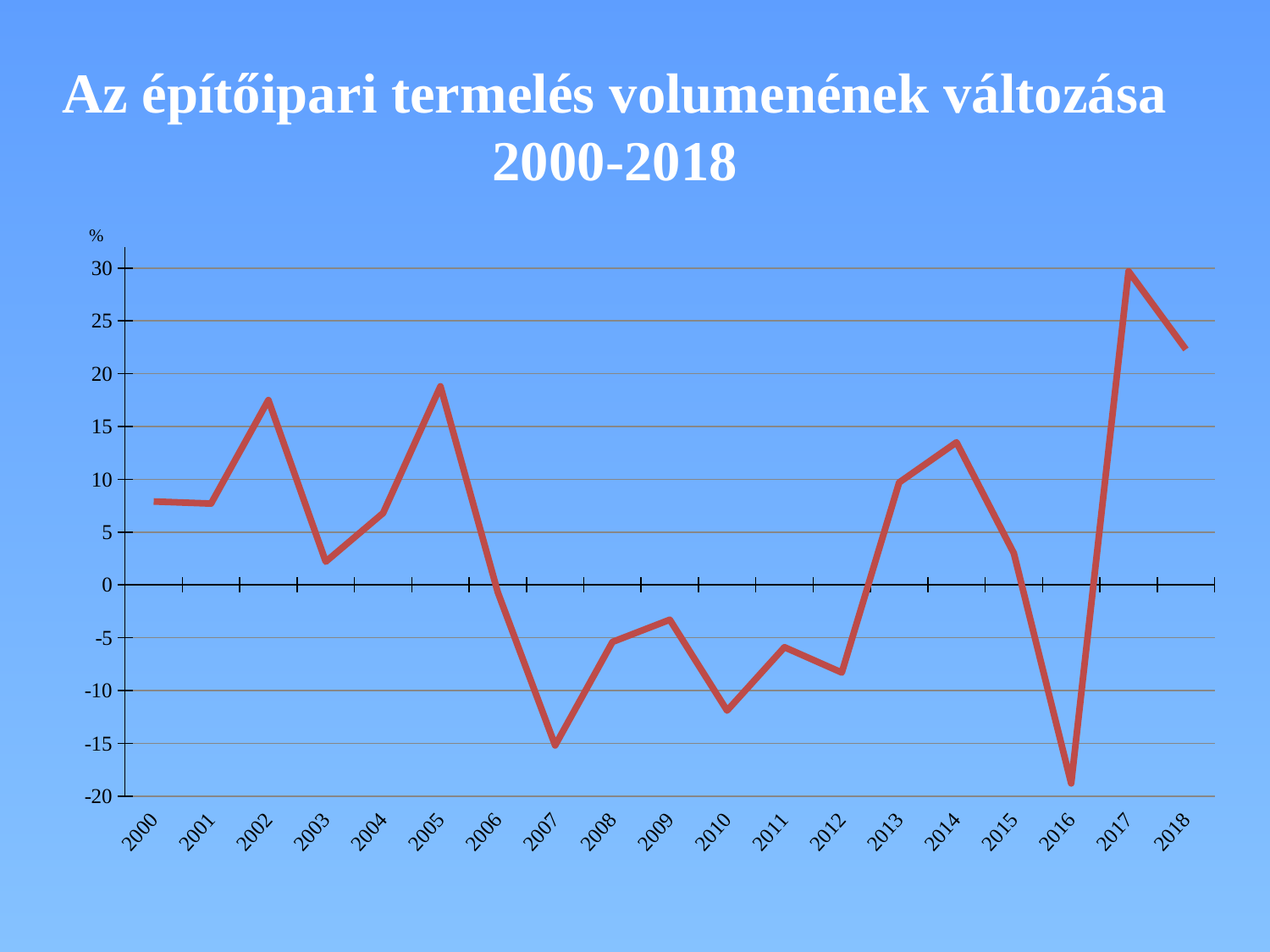
Does the value rise or fall from 2017 to 2018? fall Is the value for 2007 greater or less than -10? less Which is larger, the value for 2009 or the value for 2010? 2009 Which year has the lowest value? 2016 What is the title of the chart? Az építőipari termelés volumenének változása 2000-2018 What kind of chart is shown on the slide? line chart Is the value for 2014 greater or less than 10? greater Which is larger, the value for 2013 or the value for 2015? 2013 Is the value for 2016 greater or less than -15? less How many years are plotted on the x axis? 19 Which year has the highest value? 2017